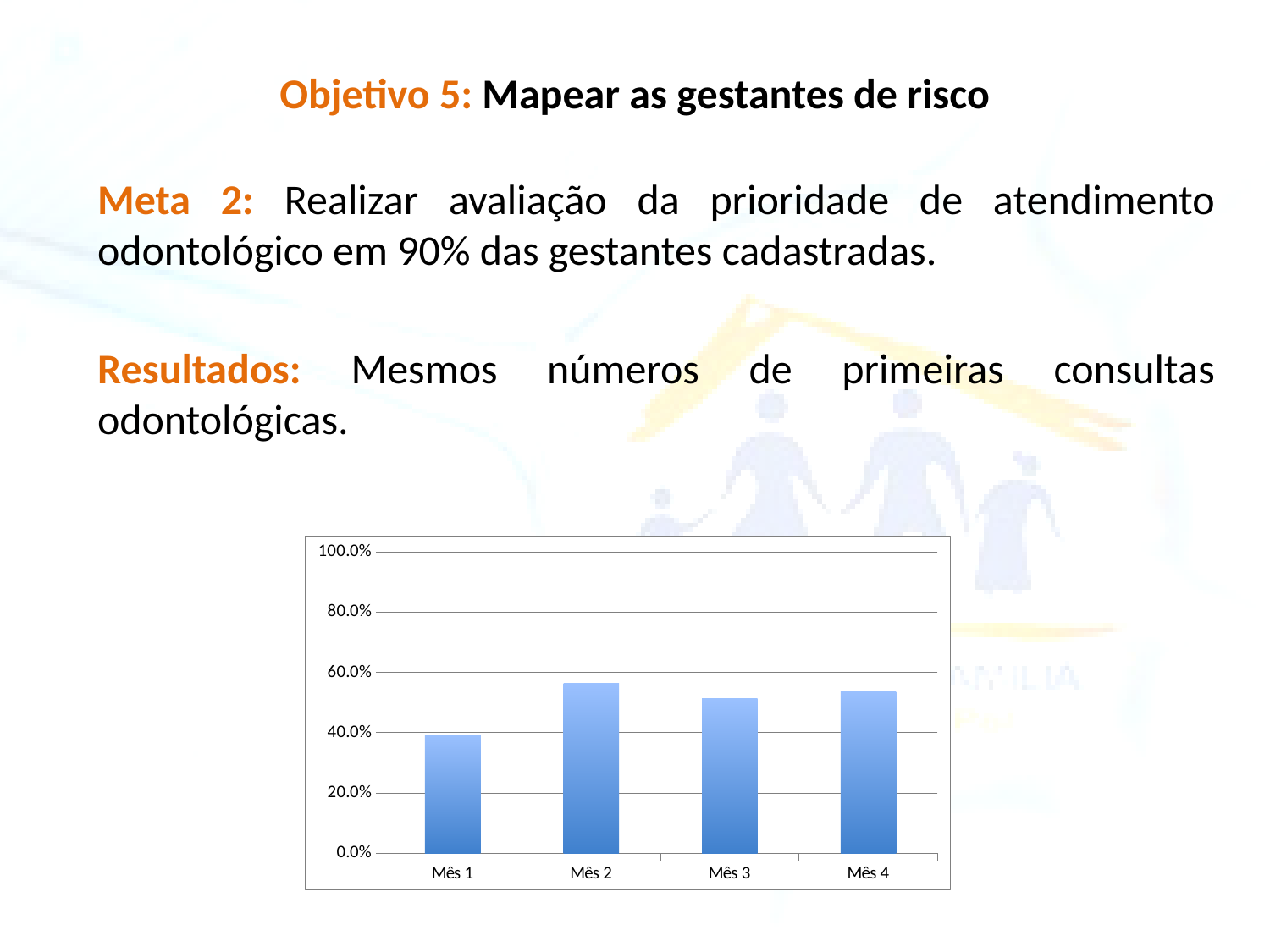
Does the value rise or fall from Mês 1 to Mês 2? rise Which month has the lowest bar in the chart? Mês 1 What is the highest value shown on the chart's y axis? 100.0% Which is larger, the value for Mês 2 or the value for Mês 3? Mês 2 Is the value for Mês 3 greater or less than 40.0%? greater Is the value for Mês 4 greater or less than 80.0%? less Which is larger, the value for Mês 1 or the value for Mês 2? Mês 2 Which month has the highest bar in the chart? Mês 2 What kind of chart is shown on the slide? bar chart Is the value for Mês 2 greater or less than 60.0%? less How many categories (months) are shown on the x axis of the chart? 4